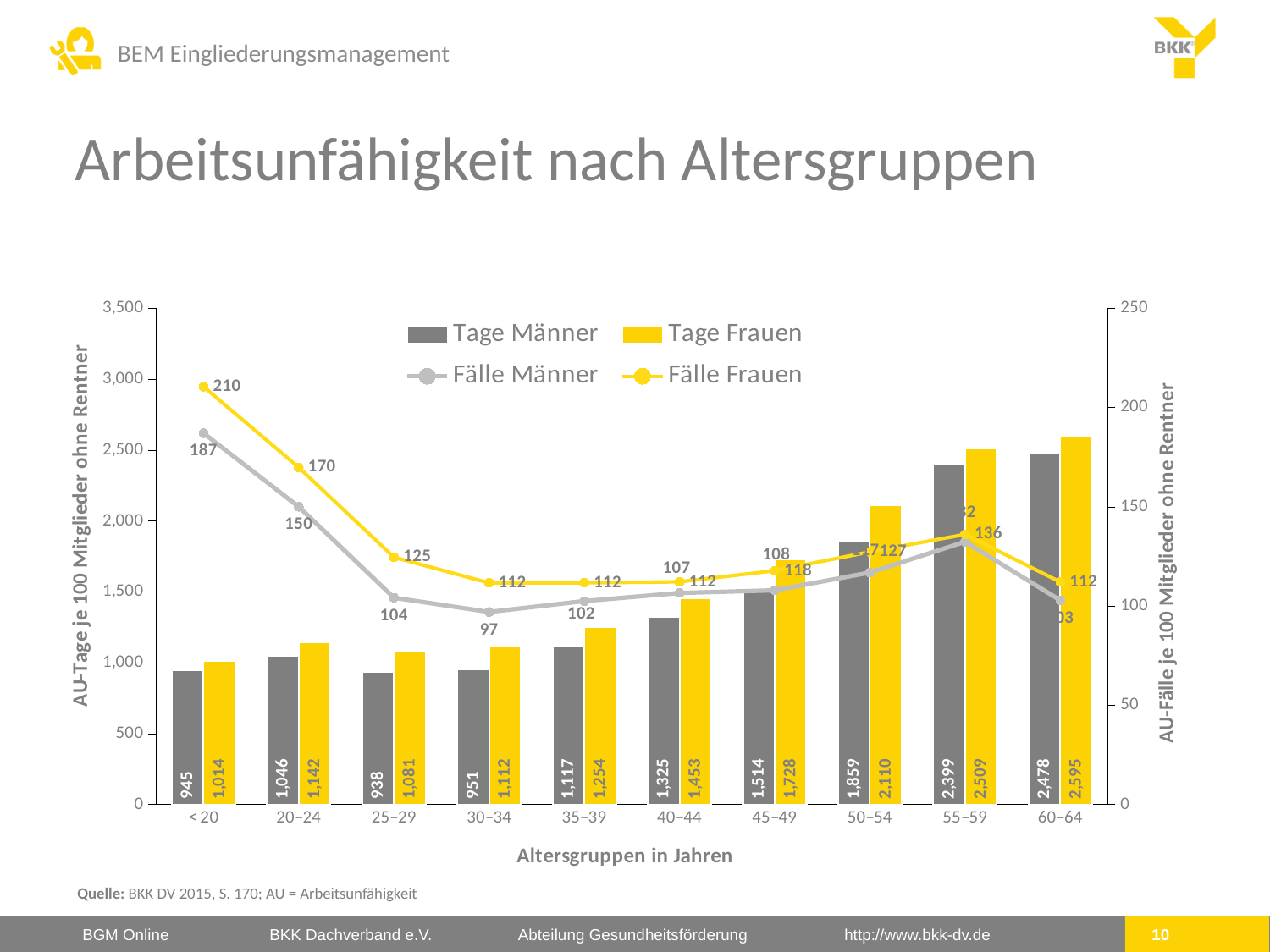
How many series does the legend list? 4 Do the Tage Männer values rise or fall from the 40–44 age group to the 60–64 age group? Rise How many age groups are shown on the x axis? 10 Which age group has the highest value for Tage Frauen? 60–64 What is the value of Fälle Männer for the 30–34 age group? 97 Which age group has the lowest value for Tage Männer? 25–29 What kind of chart is shown on the slide? Combined bar and line chart What is the value of Tage Frauen for the < 20 age group? 1,014 What is the difference between Tage Frauen and Tage Männer for the 60–64 age group? 117 For the 40–44 age group, which is larger: Tage Männer or Tage Frauen? Tage Frauen What is the value of Fälle Frauen for the < 20 age group? 210 What is the value of Tage Männer for the 55–59 age group? 2,399